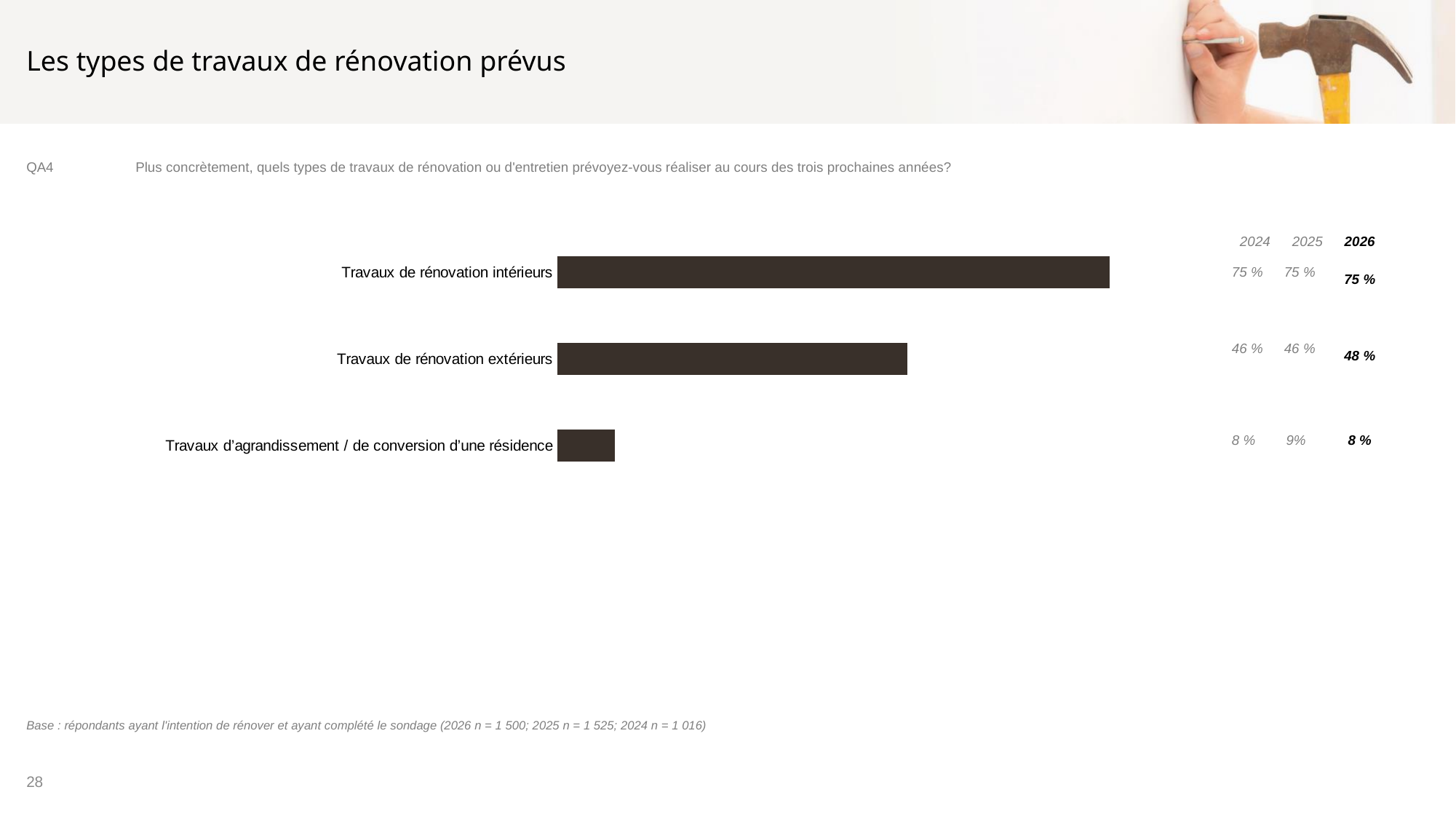
How many categories are shown in the chart? 3 What is the difference between the 2026 values for Travaux de rénovation intérieurs and Travaux de rénovation extérieurs? 27 % How many years of data are listed in the table next to the chart? 3 What kind of chart is shown on the slide? Bar chart What is the 2026 value for Travaux de rénovation extérieurs? 48 % Which category has the lowest 2026 value? Travaux d'agrandissement / de conversion d'une résidence What was the 2024 value for Travaux d'agrandissement / de conversion d'une résidence? 8 % What was the 2025 value for Travaux de rénovation extérieurs? 46 % Which category has the highest 2026 value? Travaux de rénovation intérieurs What is the 2026 value for Travaux de rénovation intérieurs? 75 % What is the 2026 value for Travaux d'agrandissement / de conversion d'une résidence? 8 % Which is larger in 2026: Travaux de rénovation extérieurs or Travaux d'agrandissement / de conversion d'une résidence? Travaux de rénovation extérieurs